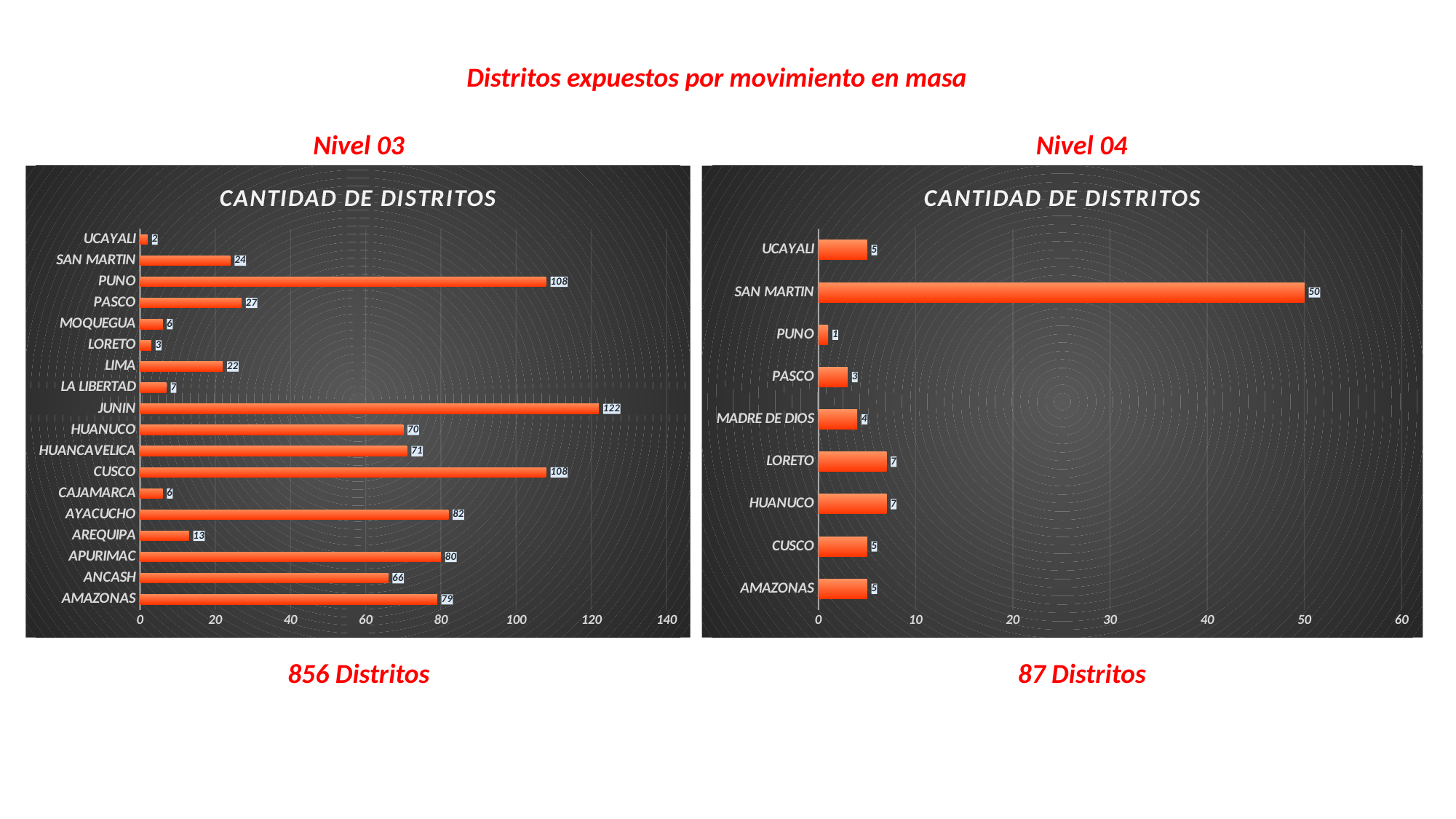
In the Nivel 03 chart on the left, which category has the highest value? JUNIN In the Nivel 03 chart on the left, which is larger, the value for AYACUCHO or the value for APURIMAC? AYACUCHO In the Nivel 04 chart on the right, which category has the lowest value? PUNO What type of chart is the Nivel 04 chart on the right? Bar chart What is the title shown inside the Nivel 03 chart on the left? CANTIDAD DE DISTRITOS In the Nivel 04 chart on the right, what is the value for SAN MARTIN? 50 How many categories are shown in the Nivel 03 chart on the left? 18 In the Nivel 03 chart on the left, what is the value for HUANCAVELICA? 71 In the Nivel 04 chart on the right, is the value for SAN MARTIN greater or less than 40? greater How many categories are shown in the Nivel 04 chart on the right? 9 In the Nivel 03 chart on the left, what is the difference between the values for JUNIN and PUNO? 14 In the Nivel 03 chart on the left, what is the value for JUNIN? 122